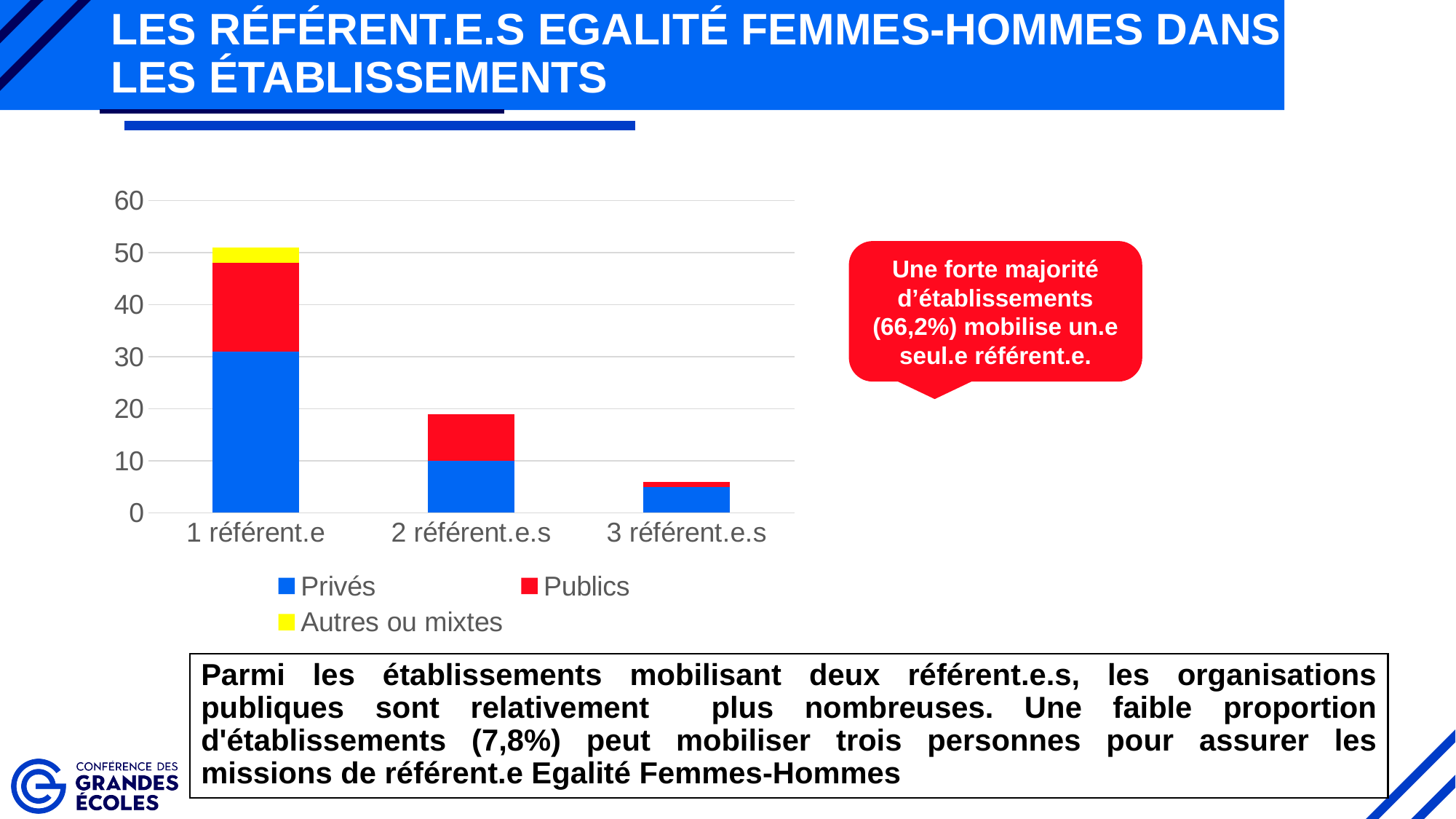
How many categories are shown on the x axis of the chart? 3 Is the total stacked value for 1 référent.e greater or less than 40? greater What kind of chart is shown on the slide? stacked bar chart Which category has the tallest stacked bar? 1 référent.e Which category has the shortest stacked bar? 3 référent.e.s Which series is shown in yellow in the chart legend? Autres ou mixtes Do the total stacked values rise or fall from 1 référent.e to 3 référent.e.s? fall Is the total stacked value for 3 référent.e.s greater or less than 10? less How many series does the chart legend list? 3 Which series is shown in red in the chart legend? Publics